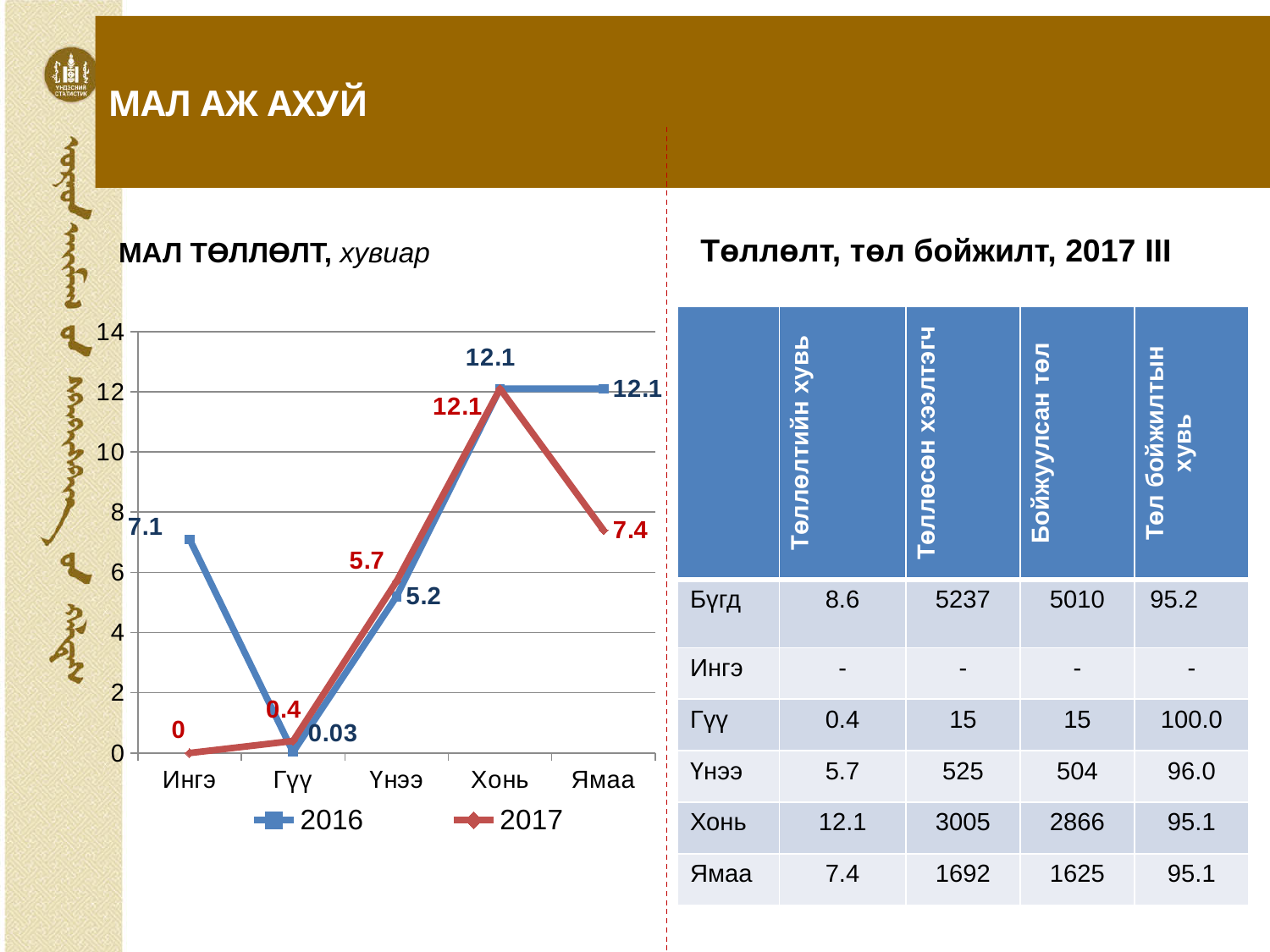
What is the 2017 value for Ямаа? 7.4 What is the 2016 value for Ингэ? 7.1 What is the 2017 value for Үнээ? 5.7 Which category has the lowest 2017 value? Ингэ Which is larger for Үнээ, the 2016 value or the 2017 value? 2017 What type of chart is shown on the slide? line chart What is the 2016 value for Гүү? 0.03 Which category has the lowest 2016 value? Гүү How many categories are shown on the x axis of the chart? 5 How many series does the chart legend list? 2 Does the 2017 line rise or fall from Хонь to Ямаа? fall What is the difference between the 2016 and 2017 values for Ямаа? 4.7